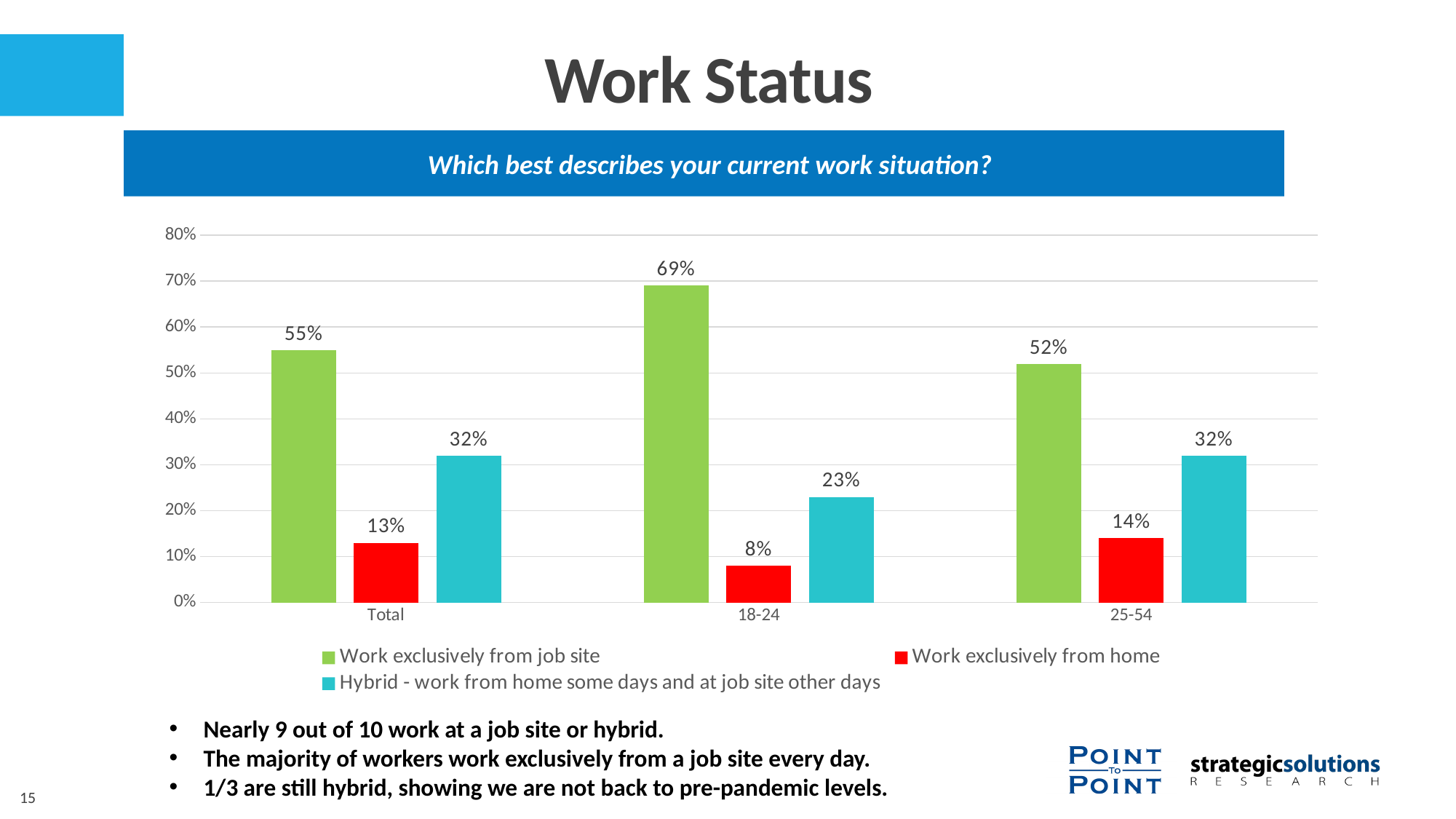
Which group has the lowest value for 'Work exclusively from home'? 18-24 What is the difference between the 'Work exclusively from job site' values for 18-24 and 25-54? 17% Is the 'Work exclusively from job site' value for 18-24 greater or less than 60%? greater What percentage of the Total group works exclusively from a job site? 55% How many series does the legend list? 3 How many groups are shown on the x axis? 3 What colour represents 'Work exclusively from home' in the chart? Red What is the value for 'Work exclusively from home' in the 18-24 group? 8% What is the Hybrid value for the 25-54 group? 32% What type of chart is shown on the slide? Bar chart Which age group has the highest value for 'Work exclusively from job site'? 18-24 Which is larger: the Hybrid value for 18-24 or the Hybrid value for 25-54? 25-54